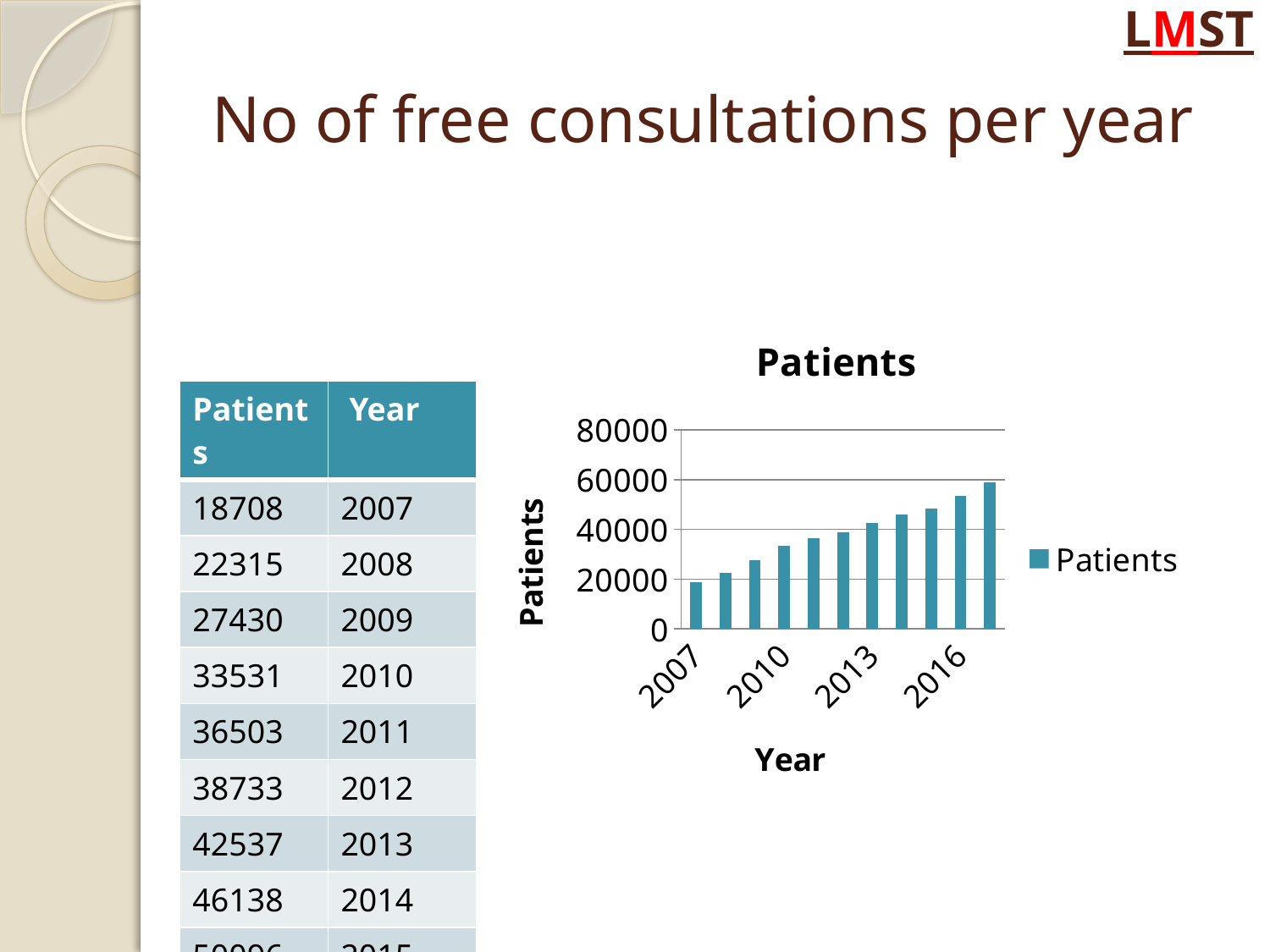
How many bars are plotted in the chart? 11 What is the label on the y axis of the chart? Patients What is the difference in patients between 2008 and 2007? 3607 What is the number of patients for 2007? 18708 Which year has the lowest number of patients in the chart? 2007 How many series does the chart legend list? 1 Which year has more patients, 2009 or 2010? 2010 Do the values in the chart rise or fall from 2007 onwards along the x axis? rise What is the number of patients for 2013? 42537 What kind of chart is shown on the slide? bar chart Is the value for 2016 greater or less than 40000? greater What is the title of the chart? Patients